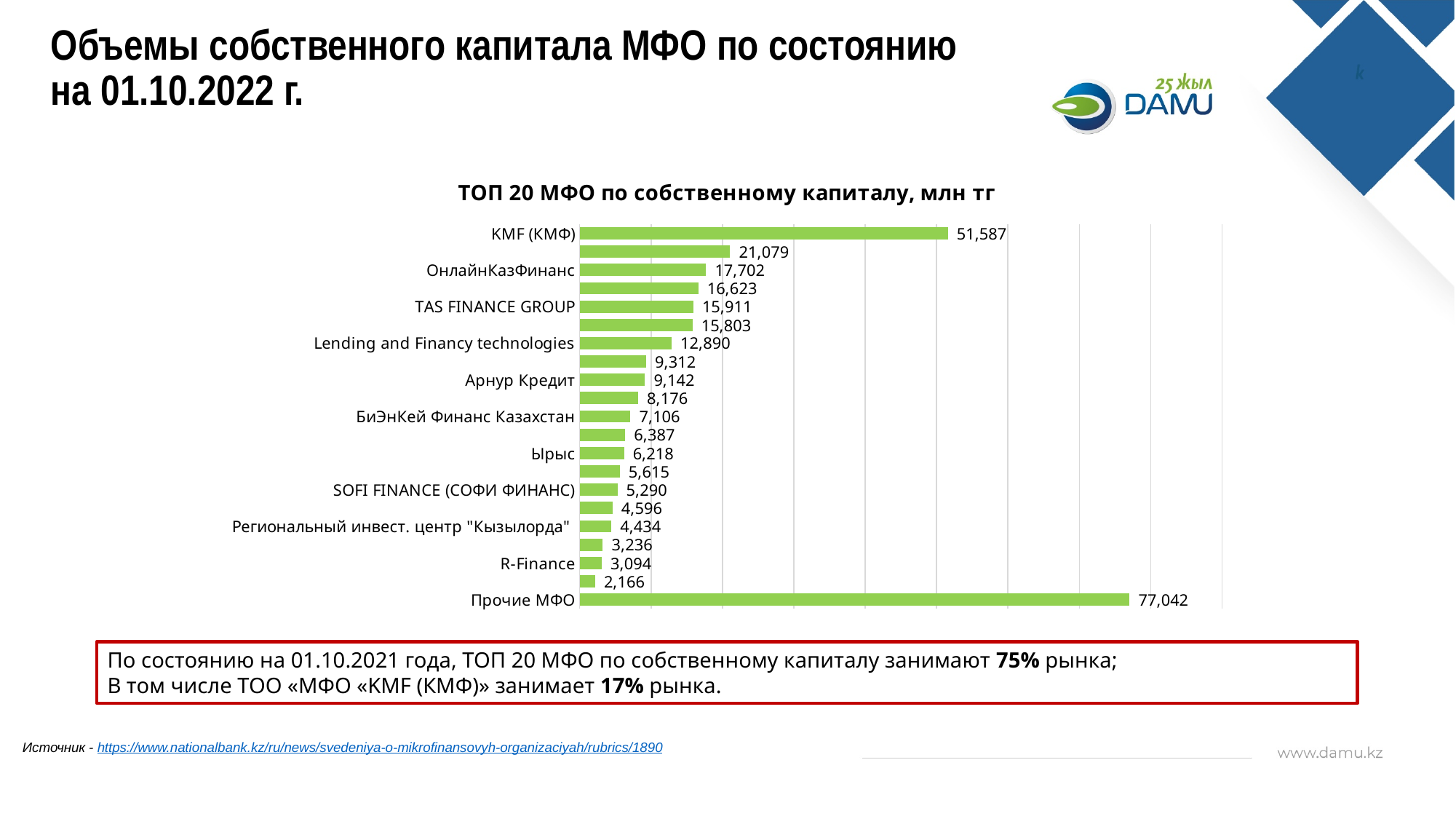
How many bars are plotted on the chart? 21 What is the smallest value labeled on the chart? 2,166 What is the value for R-Finance? 3,094 What is the value for KMF (КМФ)? 51,587 Which is larger, the value for Арнур Кредит or the value for Ырыс? Арнур Кредит What kind of chart is shown on the slide? Bar chart What is the difference between the values for Прочие МФО and KMF (КМФ)? 25,455 What is the value for Прочие МФО? 77,042 What is the difference between the values for KMF (КМФ) and ОнлайнКазФинанс? 33,885 Which category has the longest bar? Прочие МФО What is the value for TAS FINANCE GROUP? 15,911 What is the value for Lending and Financy technologies? 12,890